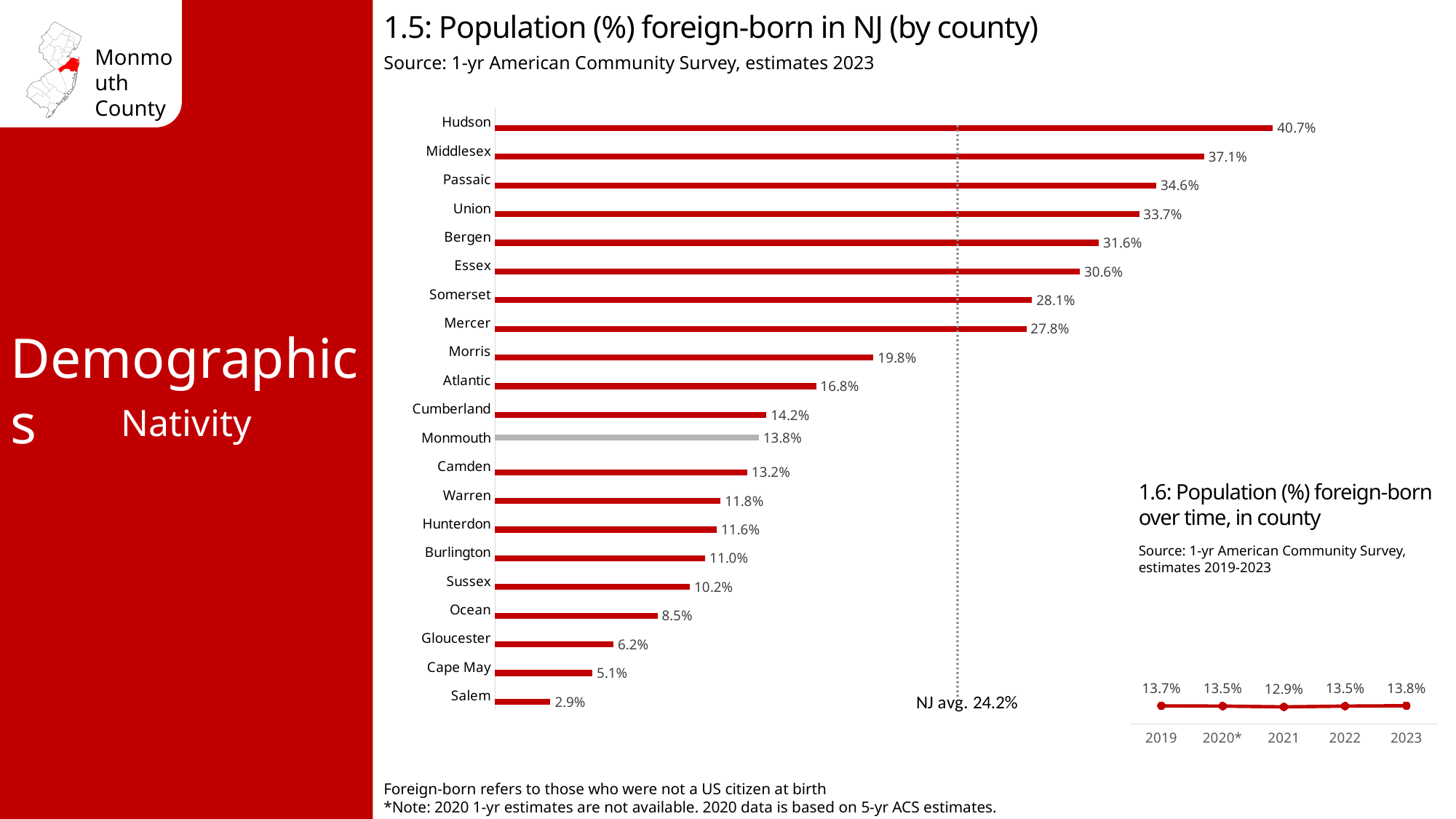
In the chart '1.5: Population (%) foreign-born in NJ (by county)', what is the value for Monmouth? 13.8% What kind of chart is '1.5: Population (%) foreign-born in NJ (by county)'? Bar chart In the chart '1.5: Population (%) foreign-born in NJ (by county)', how many counties are shown? 21 In the chart '1.6: Population (%) foreign-born over time, in county', what is the value for 2021? 12.9% In the chart '1.6: Population (%) foreign-born over time, in county', how many years are plotted? 5 In the chart '1.5: Population (%) foreign-born in NJ (by county)', which county has the highest value? Hudson In the chart '1.5: Population (%) foreign-born in NJ (by county)', what is the difference between Hudson and Middlesex? 3.6% In the chart '1.6: Population (%) foreign-born over time, in county', which year has the highest value? 2023 In the chart '1.5: Population (%) foreign-born in NJ (by county)', what NJ average is marked by the dotted line? 24.2% In the chart '1.5: Population (%) foreign-born in NJ (by county)', which county has the lowest value? Salem In the chart '1.5: Population (%) foreign-born in NJ (by county)', what is the value for Ocean? 8.5% In the chart '1.5: Population (%) foreign-born in NJ (by county)', which is larger, Bergen or Essex? Bergen